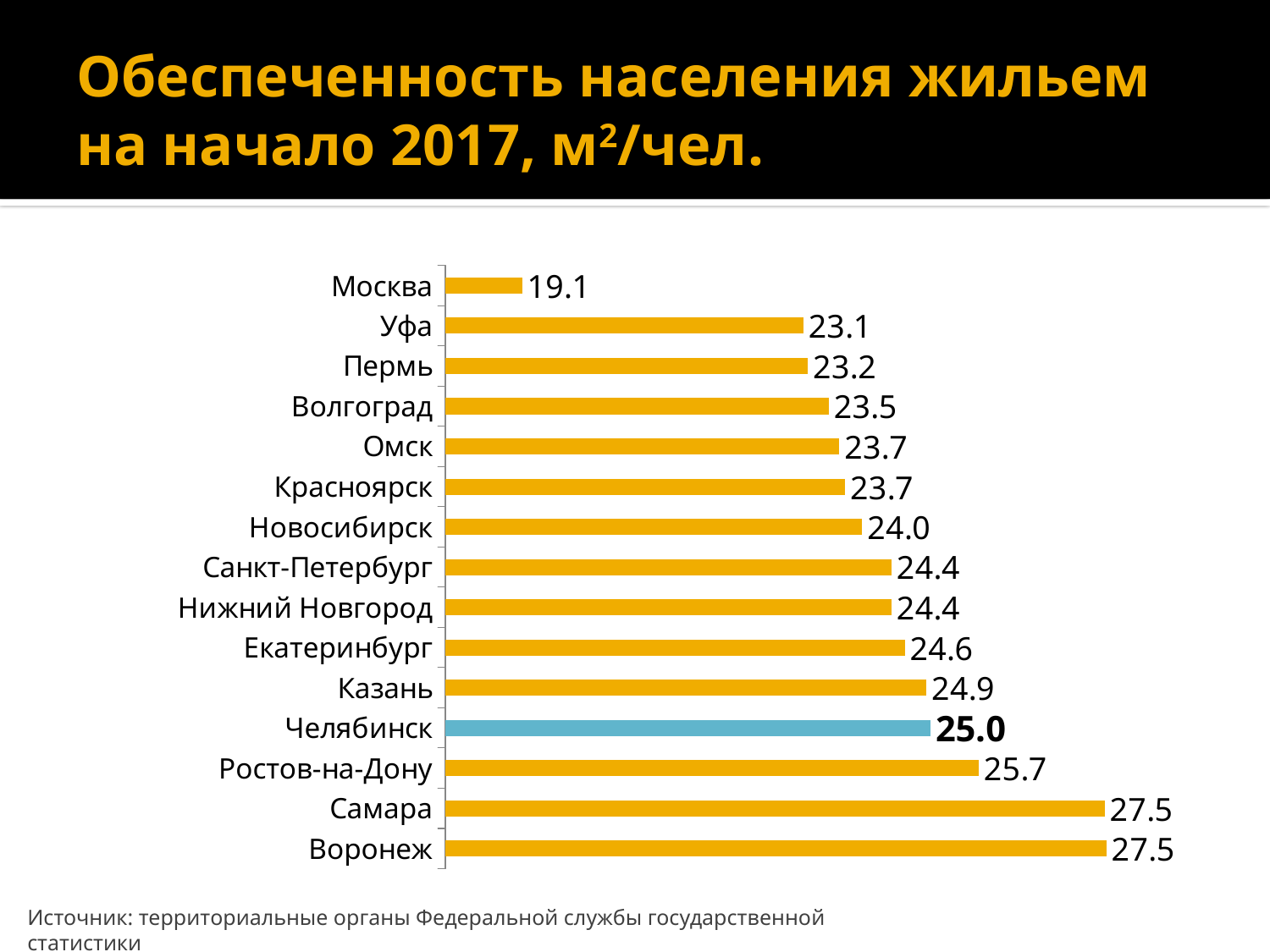
Which city's bar is highlighted in a different colour (blue) from the others? Челябинск Which is larger, the value for Казань or the value for Екатеринбург? Казань What kind of chart is shown on the slide? Bar chart Which city has the lowest value? Москва What is the value for Москва? 19.1 What is the difference between the values for Ростов-на-Дону and Челябинск? 0.7 Which is larger, the value for Уфа or the value for Волгоград? Волгоград What is the value for Челябинск? 25.0 How many cities are shown in the chart? 15 What is the value for Ростов-на-Дону? 25.7 What is the difference between the values for Самара and Москва? 8.4 Which two cities share the highest value of 27.5? Самара and Воронеж